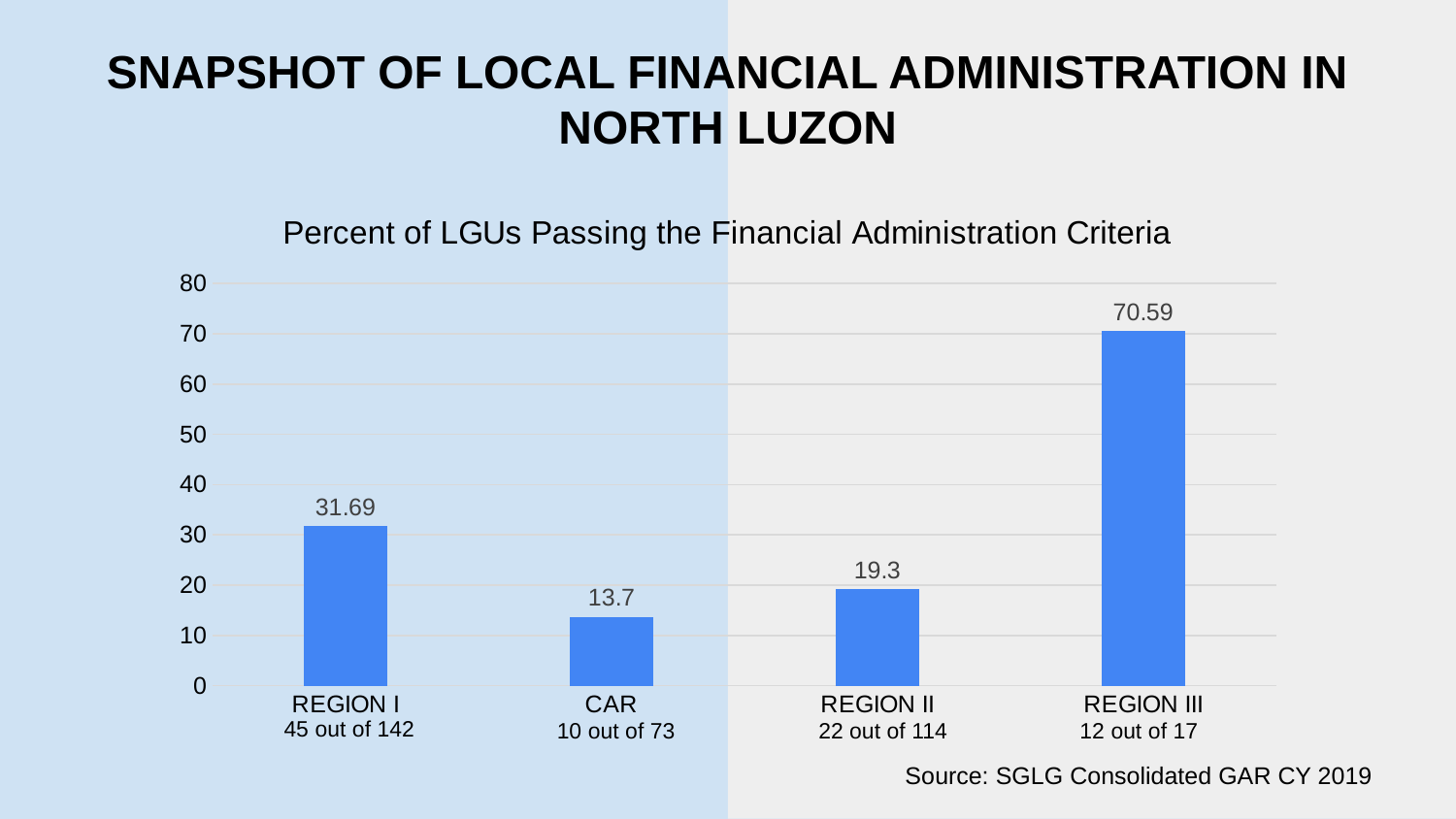
What is the difference between the values for REGION III and REGION I? 38.9 What is the value for CAR? 13.7 What kind of chart is shown on the slide? bar chart What is the value for REGION III? 70.59 How many categories are shown on the chart? 4 Which region has the lowest percent of LGUs passing the Financial Administration Criteria? CAR Which is larger, the value for REGION I or the value for REGION II? REGION I What is the value for REGION II? 19.3 What is the value for REGION I? 31.69 Is the value for REGION II greater or less than 20? less What is the title of the chart? Percent of LGUs Passing the Financial Administration Criteria Which region has the highest percent of LGUs passing the Financial Administration Criteria? REGION III